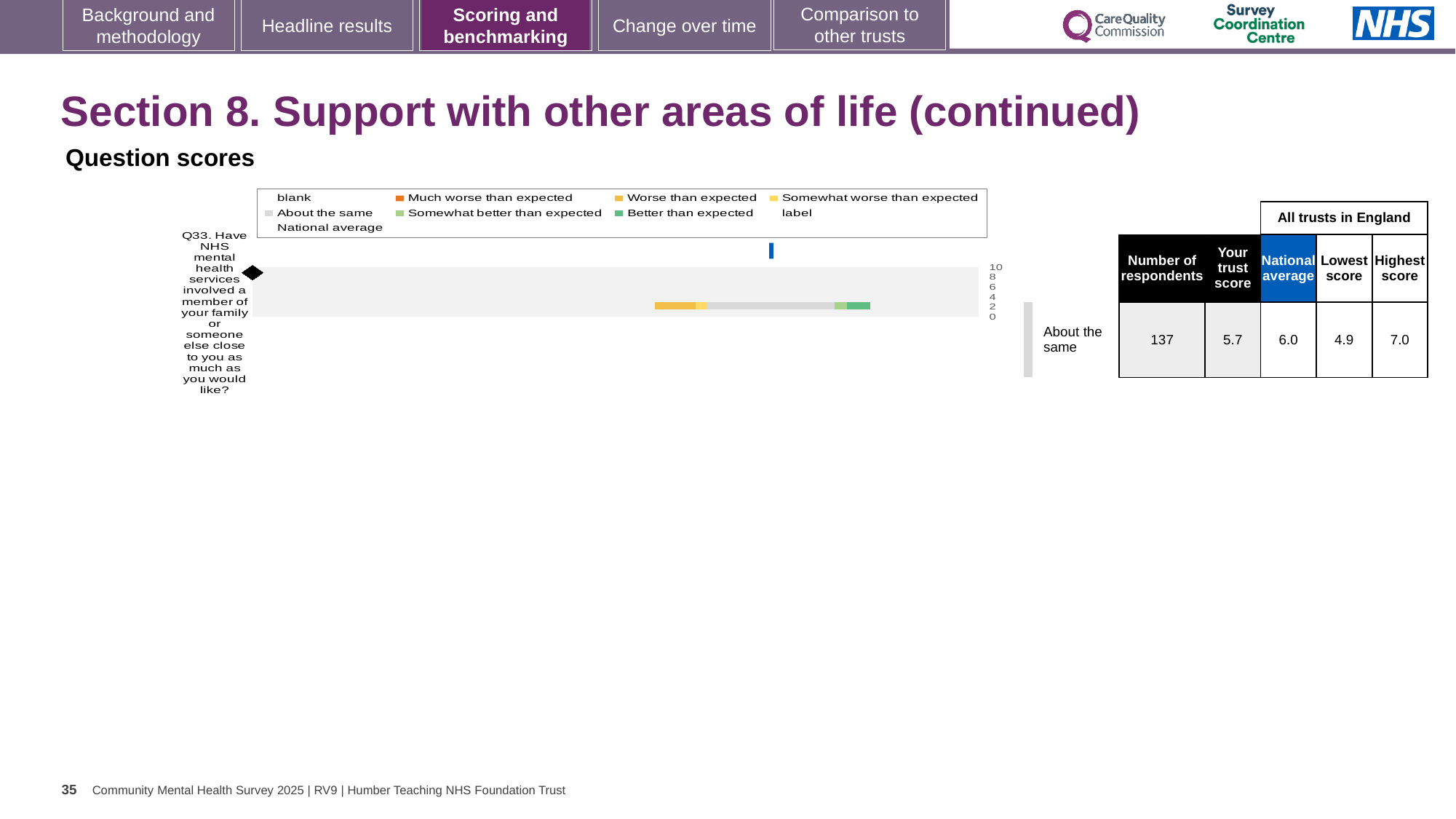
What is the difference between the highest and lowest scores for Q33 across all trusts in England? 2.1 How many questions are plotted in the chart? 1 What is the national average score for Q33? 6.0 What is the difference between the national average and the trust score for Q33? 0.3 What is the lowest score among all trusts in England for Q33? 4.9 What is the trust's score for Q33 shown on the slide? 5.7 What benchmark category label is shown next to the bar for Q33? About the same What is the maximum value shown on the chart's score axis? 10 What kind of chart is used to show the question score for Q33? bar chart What is the highest score among all trusts in England for Q33? 7.0 How many respondents answered Q33? 137 Which is larger for Q33, the trust score or the national average? national average